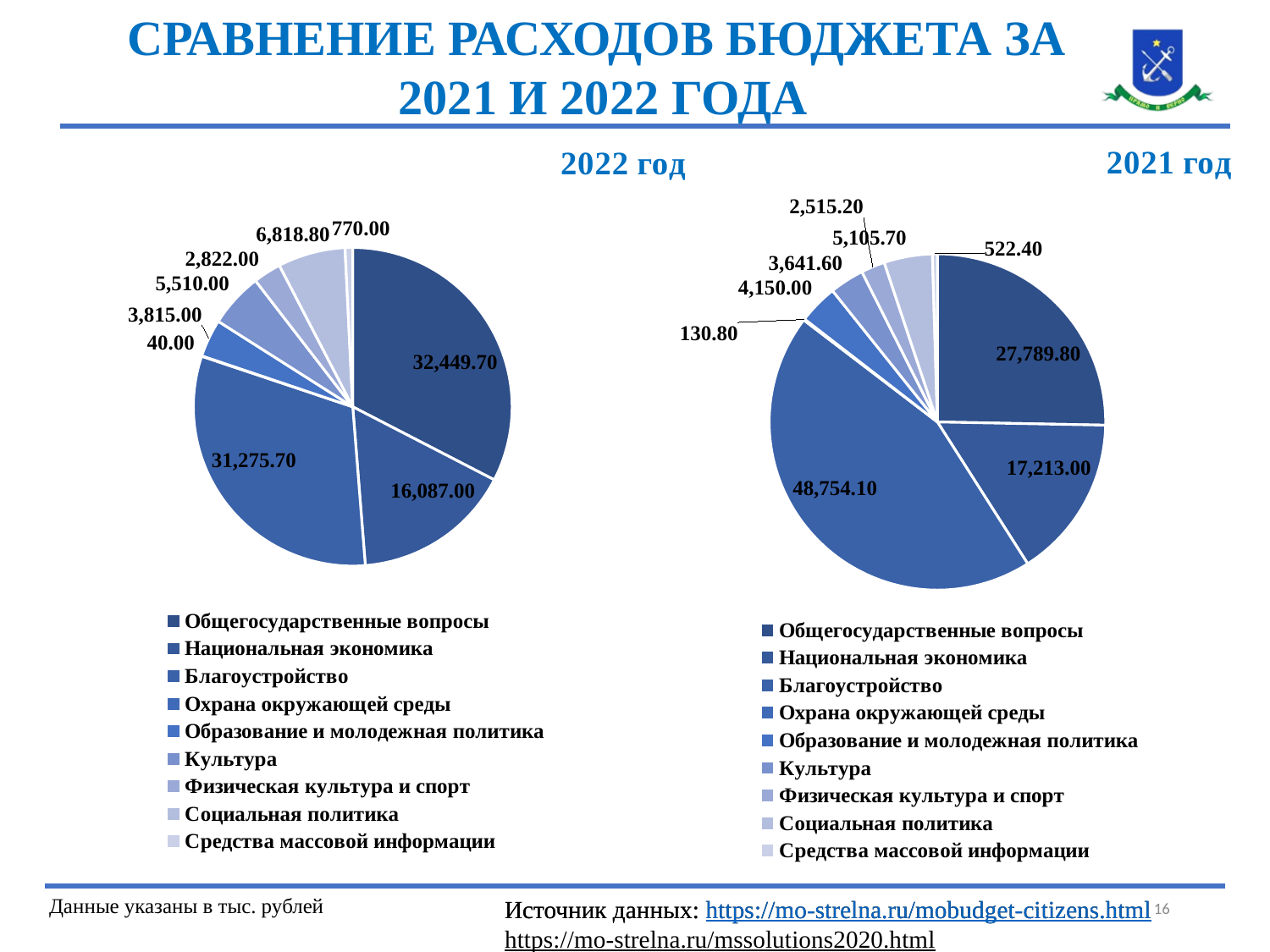
In the 2022 год chart, what is the value for Благоустройство? 31,275.70 How many categories does the legend of the 2021 год chart list? 9 In the 2021 год chart, which category has the largest value? Благоустройство In the 2022 год chart, what is the value for Общегосударственные вопросы? 32,449.70 What type of chart is used for the 2022 год data? Pie chart In the 2021 год chart, which category has the smallest value? Охрана окружающей среды In the 2022 год chart, what is the value for Социальная политика? 6,818.80 In the 2022 год chart, which is larger: Общегосударственные вопросы or Благоустройство? Общегосударственные вопросы In the 2022 год chart, which category has the smallest value? Охрана окружающей среды What is the difference between the Благоустройство value in the 2021 год chart and in the 2022 год chart? 17,478.40 In the 2021 год chart, what is the value for Национальная экономика? 17,213.00 In the 2021 год chart, what is the value for Благоустройство? 48,754.10